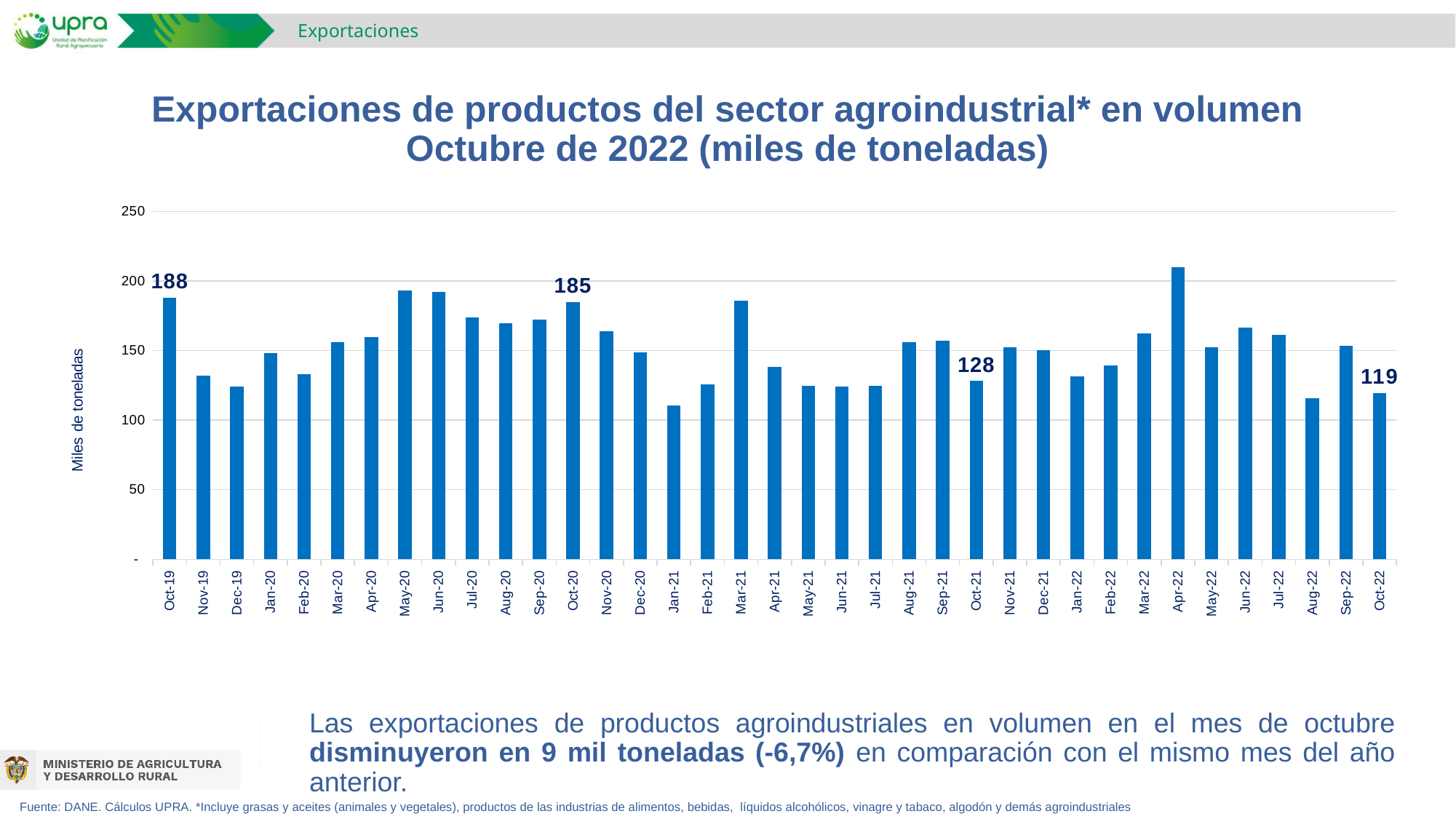
What type of chart is shown on the slide? Bar chart How many months (bars) are plotted in the chart? 37 Is the value for Apr-22 greater or less than 200? greater What is the value for Oct-20? 185 Which month has the highest bar in the chart? Apr-22 What is the value for Oct-21? 128 What is the value for Oct-22? 119 What is the label of the vertical axis? Miles de toneladas What is the difference between the values for Oct-21 and Oct-22? 9 Which is larger, the value for Oct-19 or the value for Oct-20? Oct-19 What is the value for Oct-19? 188 Is the value for Dec-19 greater or less than 150? less